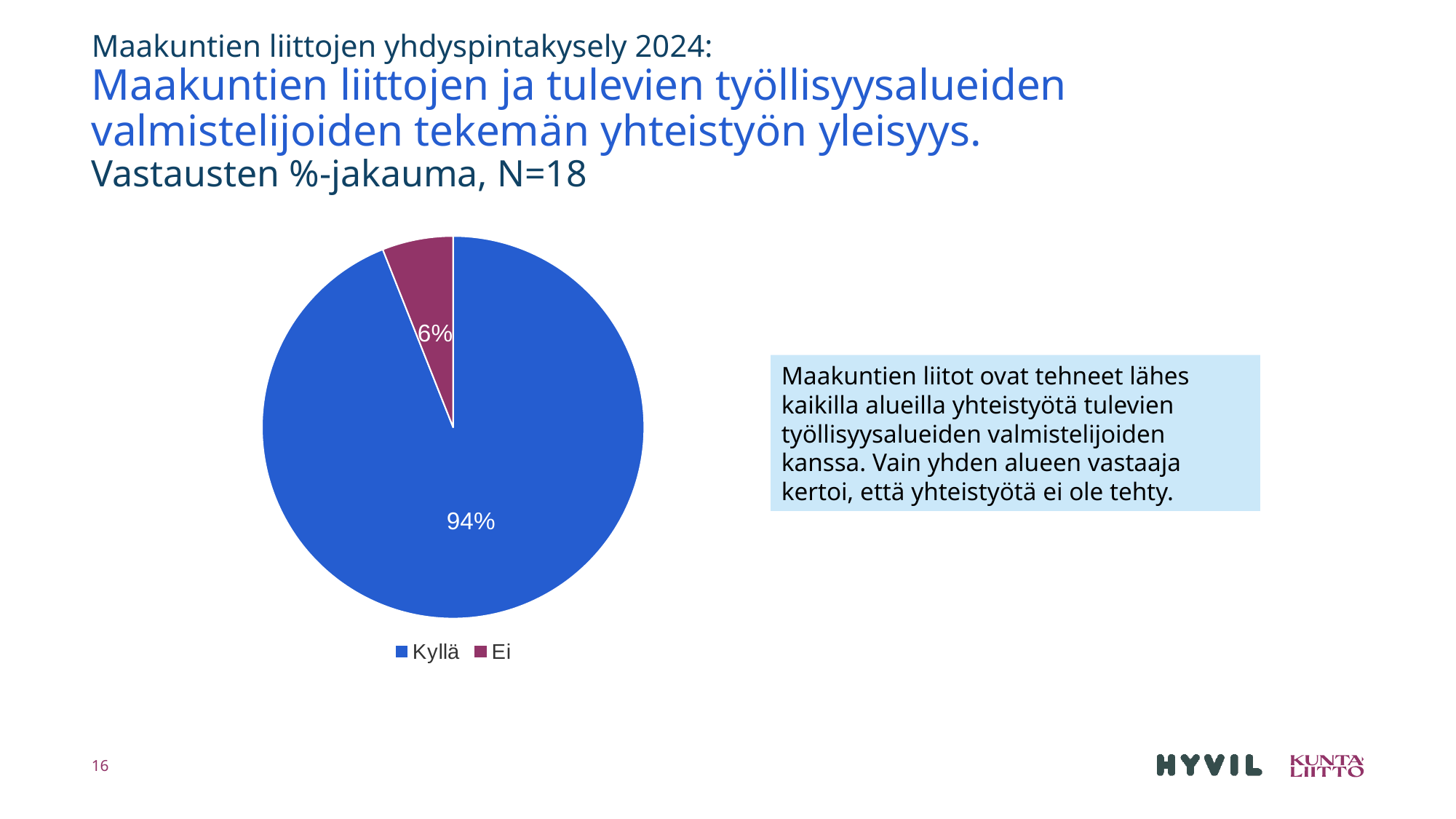
Which is larger, the share for Kyllä or the share for Ei? Kyllä What share of the pie does the Ei slice represent? 6% How many entries does the legend list? 2 What colour is the Kyllä slice in the pie chart? blue What kind of chart is shown on the slide? pie chart Which category has the largest share of the pie? Kyllä What percentage of responses is shown for Ei? 6% What is the difference in percentage points between Kyllä and Ei? 88 What is the number of respondents (N) stated in the chart subtitle? 18 Which category has the smallest share of the pie? Ei How many slices does the pie chart have? 2 What percentage of responses is shown for Kyllä? 94%